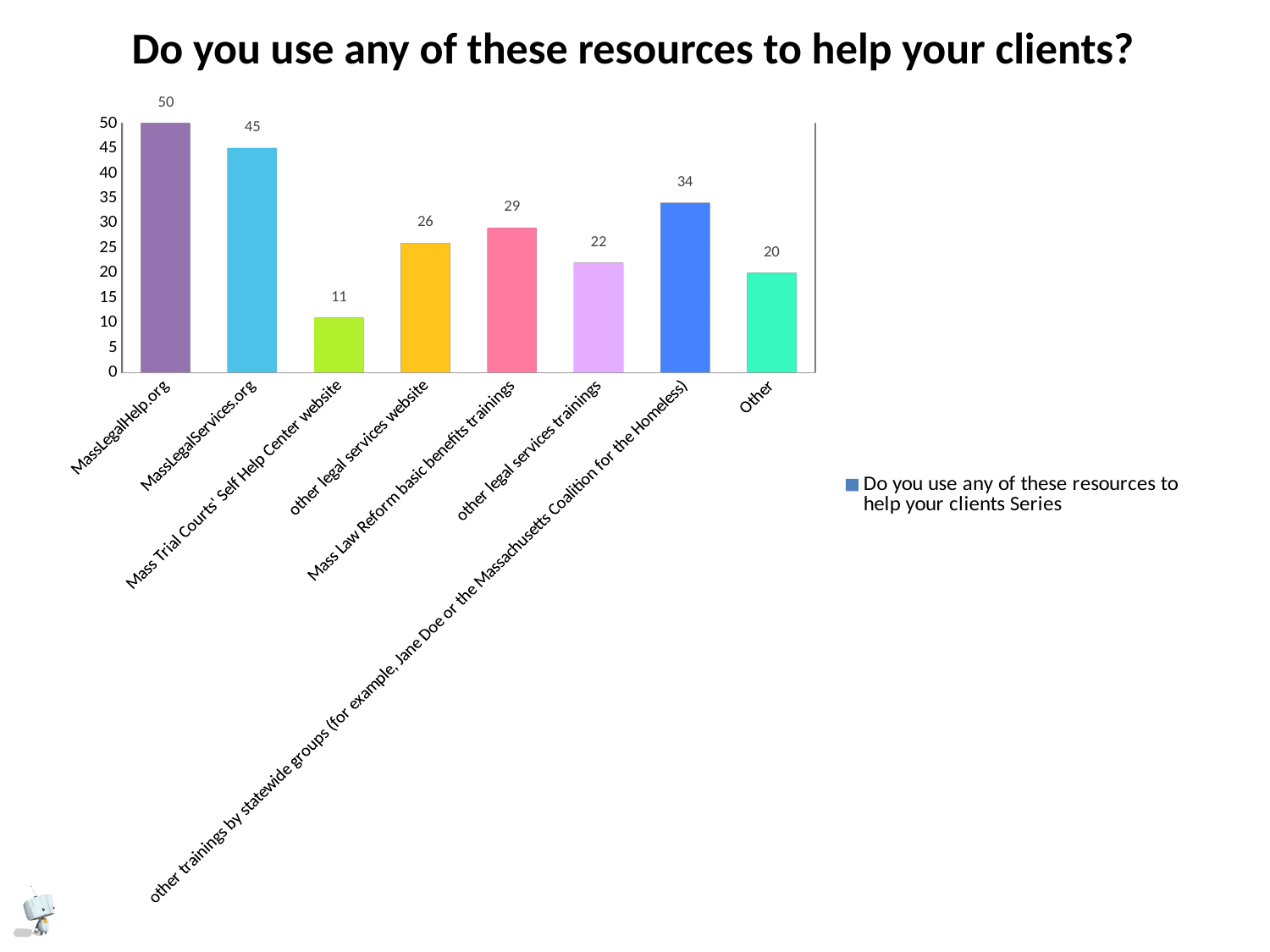
What is the title of the chart? Do you use any of these resources to help your clients? How many categories are shown on the x axis? 8 How many series does the legend list? 1 What is the difference between the values for MassLegalHelp.org and MassLegalServices.org? 5 What is the value for Mass Law Reform basic benefits trainings? 29 What is the value for Mass Trial Courts' Self Help Center website? 11 What kind of chart is shown on the slide? bar chart Which category has the lowest value? Mass Trial Courts' Self Help Center website What is the value for Other? 20 What is the value for MassLegalHelp.org? 50 Which is larger: the value for other legal services website or the value for other legal services trainings? other legal services website Which category has the highest value? MassLegalHelp.org